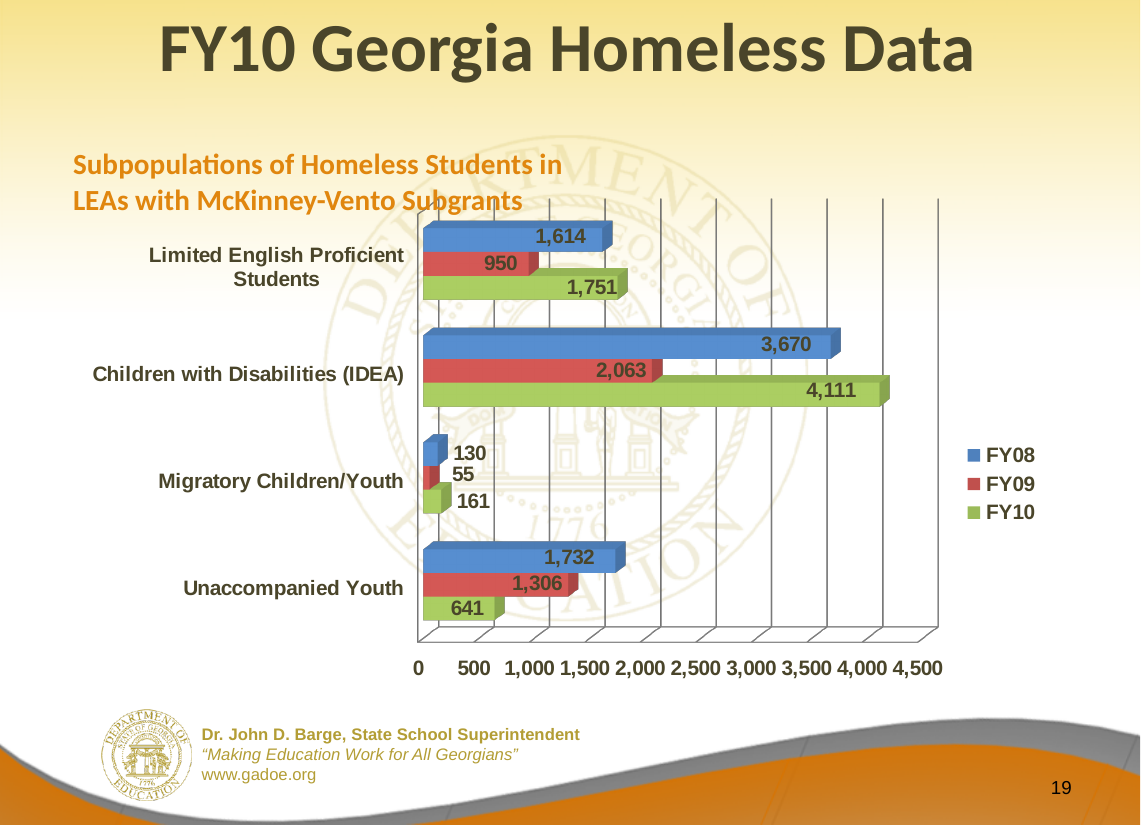
Which series is shown in green in the legend? FY10 How many categories are shown on the chart? 4 What is the FY08 value for Limited English Proficient Students? 1,614 Which category has the lowest FY09 value? Migratory Children/Youth What is the FY10 value for Children with Disabilities (IDEA)? 4,111 What kind of chart is shown on the slide? Bar chart Which category has the highest FY10 value? Children with Disabilities (IDEA) What is the FY09 value for Unaccompanied Youth? 1,306 How many series does the legend list? 3 Is the FY08 value for Children with Disabilities (IDEA) greater or less than 3,500? greater What is the difference between the FY10 and FY09 values for Children with Disabilities (IDEA)? 2,048 Which is larger for Unaccompanied Youth, the FY08 value or the FY10 value? FY08